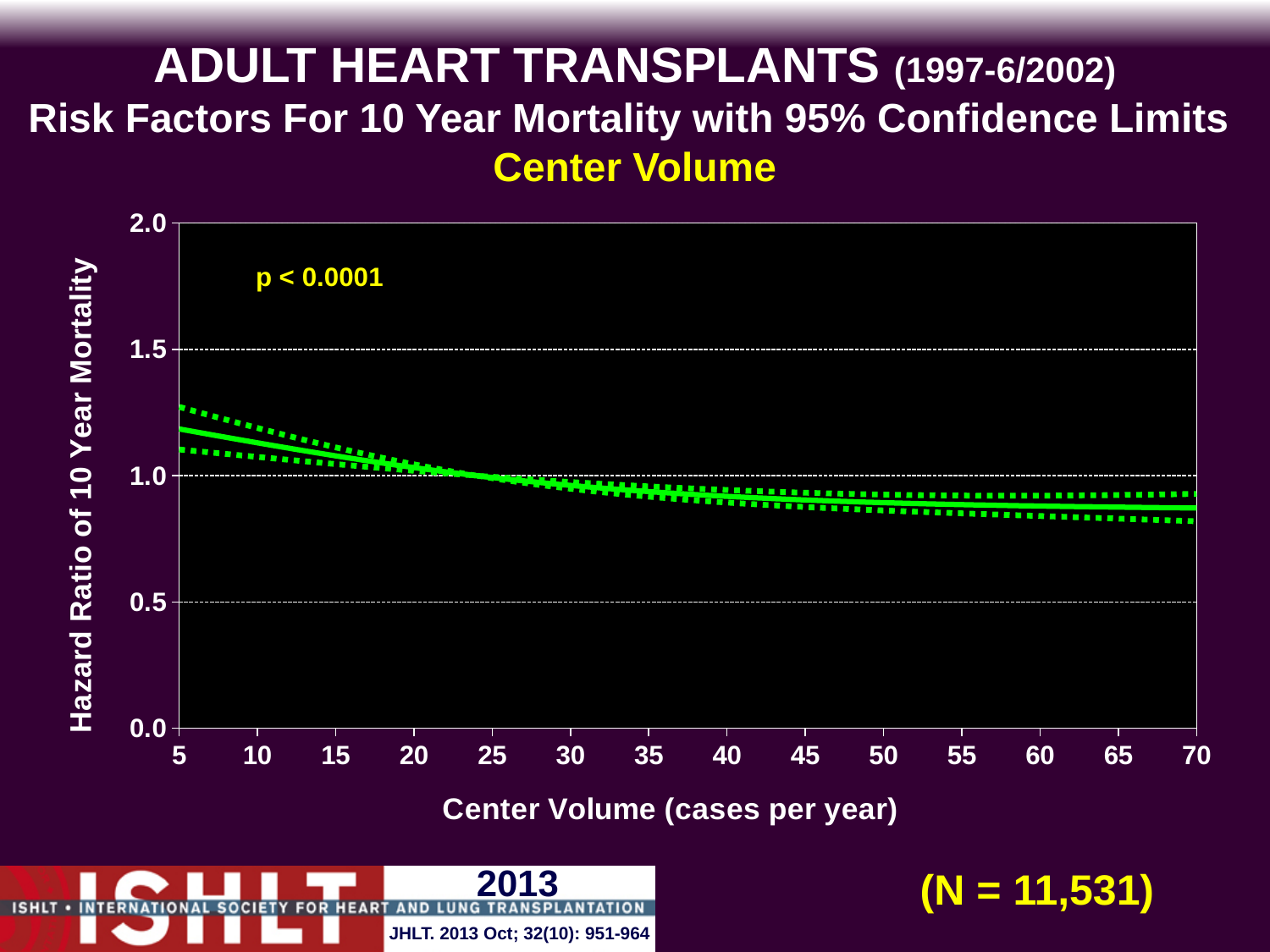
Is the upper 95% confidence limit at a center volume of 5 cases per year greater or less than 1.0? greater Which has the higher hazard ratio: a center volume of 10 cases per year or 60 cases per year? 10 cases per year Is the lower 95% confidence limit at a center volume of 70 cases per year greater or less than 0.5? greater Is the hazard ratio at a center volume of 50 cases per year greater or less than 1.0? less What is the label of the y axis? Hazard Ratio of 10 Year Mortality Does the hazard ratio of 10 year mortality rise or fall as center volume increases from 5 to 70 cases per year? fall What kind of chart is shown on the slide? line chart How many tick labels are shown on the x axis (Center Volume)? 14 What p-value is printed on the chart? p < 0.0001